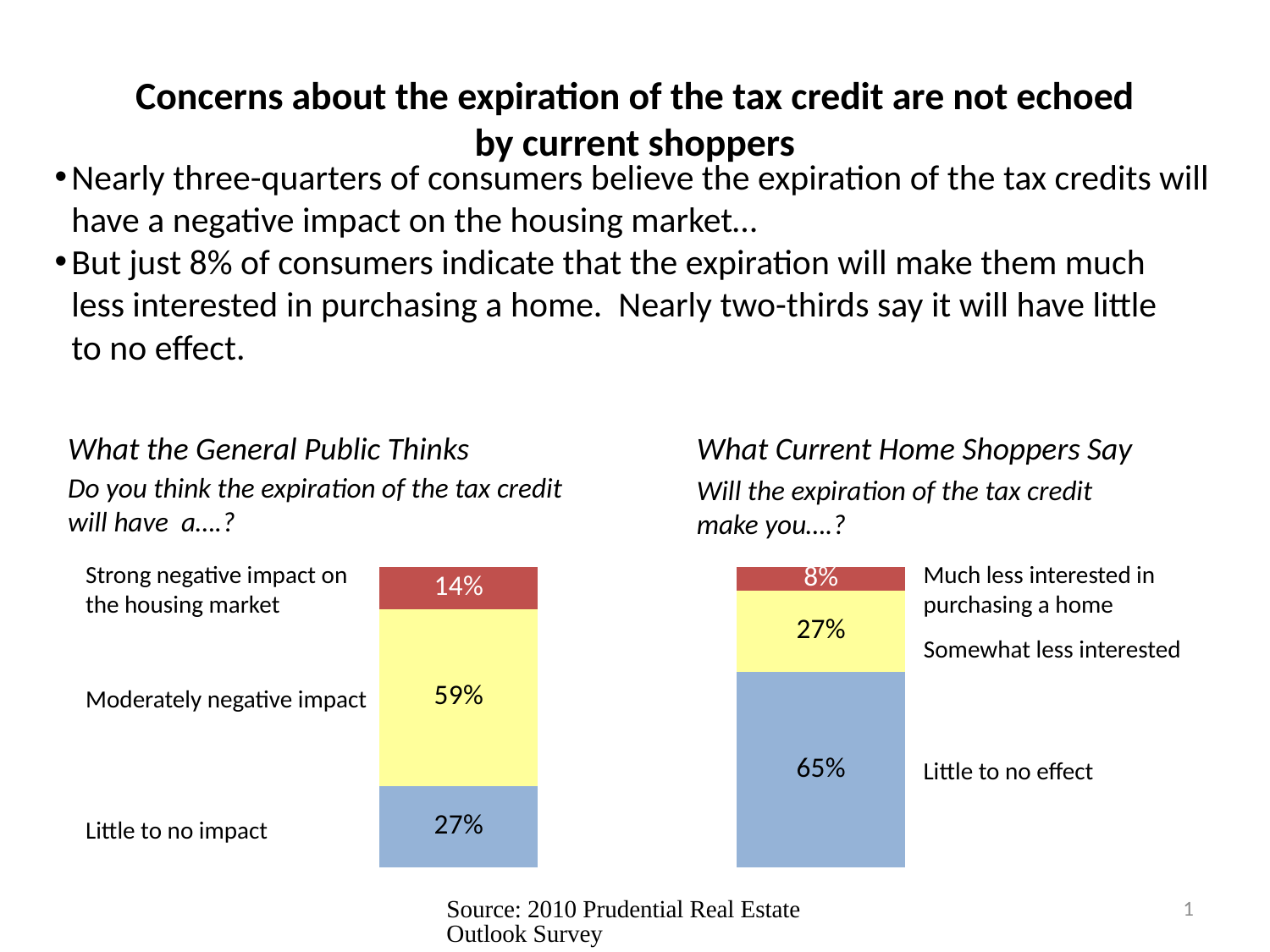
In the 'What the General Public Thinks' chart, which response has the largest share? Moderately negative impact In the 'What the General Public Thinks' chart, what percentage said the expiration would have a moderately negative impact? 59% In the 'What the General Public Thinks' chart, what percentage said the expiration would have little to no impact? 27% What type of chart is used for 'What the General Public Thinks'? Stacked bar chart In the 'What Current Home Shoppers Say' chart, what percentage said the expiration would have little to no effect? 65% In the 'What the General Public Thinks' chart, what is the difference between the moderately negative impact share and the little to no impact share? 32% In the 'What Current Home Shoppers Say' chart, what percentage said the expiration would make them much less interested in purchasing a home? 8% In the 'What the General Public Thinks' chart, what percentage said the expiration would have a strong negative impact on the housing market? 14% In the 'What Current Home Shoppers Say' chart, what is the difference between the little to no effect share and the somewhat less interested share? 38% In the 'What Current Home Shoppers Say' chart, what percentage said they would be somewhat less interested? 27% In the 'What Current Home Shoppers Say' chart, which response has the smallest share? Much less interested in purchasing a home Which is larger: the little to no impact share in the 'What the General Public Thinks' chart or the little to no effect share in the 'What Current Home Shoppers Say' chart? Little to no effect in the 'What Current Home Shoppers Say' chart